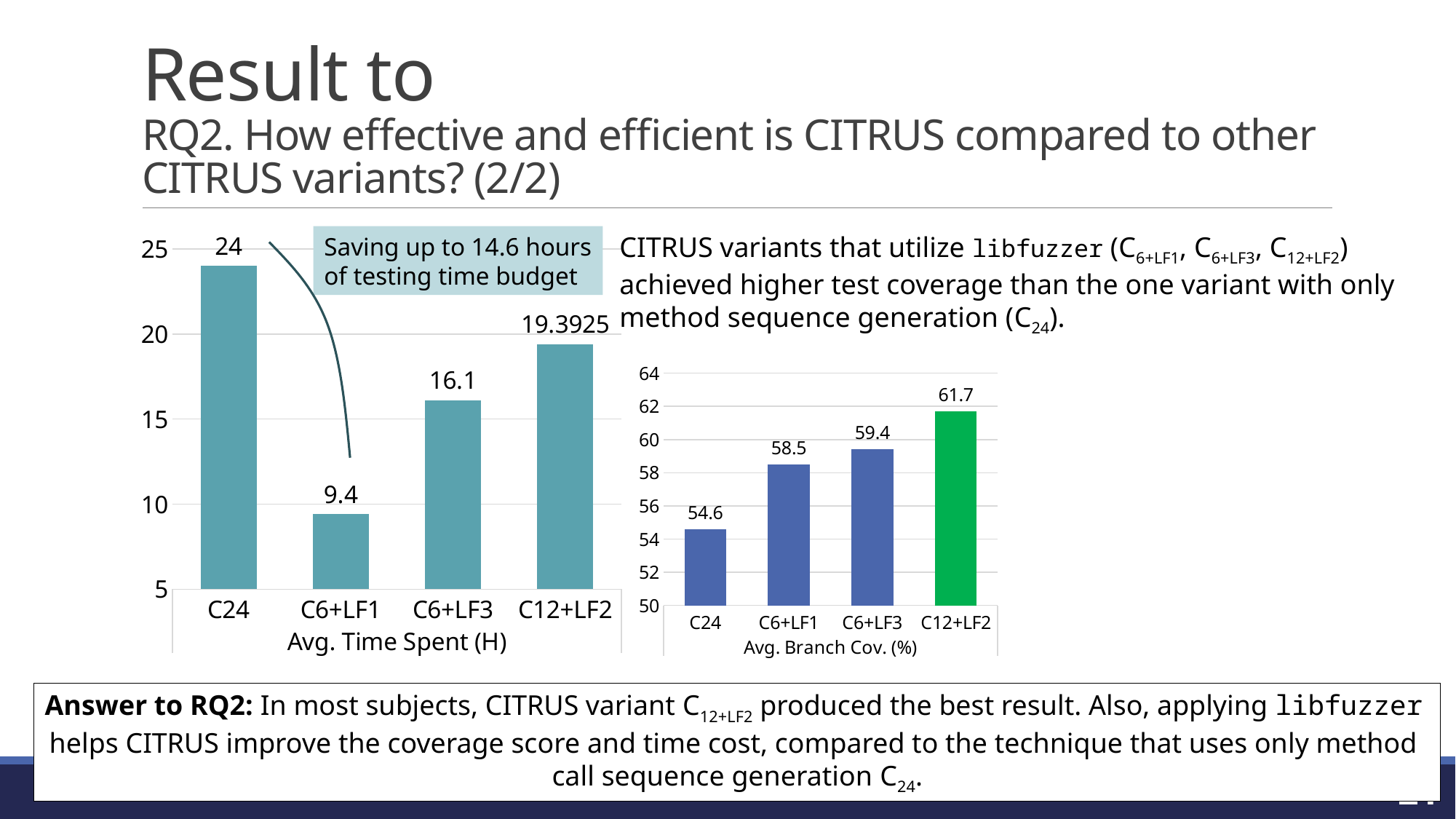
In the Avg. Branch Cov. (%) chart, do the values rise or fall from left to right? rise In the Avg. Time Spent (H) chart, which category has the highest value? C24 In the Avg. Time Spent (H) chart, which category has the lowest value? C6+LF1 In the Avg. Branch Cov. (%) chart, which bar is coloured green? C12+LF2 In the Avg. Branch Cov. (%) chart, what is the value for C6+LF3? 59.4 In the Avg. Time Spent (H) chart, what is the value for C12+LF2? 19.3925 In the Avg. Branch Cov. (%) chart, which category has the highest value? C12+LF2 In the Avg. Branch Cov. (%) chart, what is the value for C24? 54.6 In the Avg. Branch Cov. (%) chart, what is the difference between C12+LF2 and C6+LF1? 3.2 In the Avg. Time Spent (H) chart, what is the difference between C24 and C6+LF1? 14.6 In the Avg. Time Spent (H) chart, how many categories are shown? 4 In the Avg. Time Spent (H) chart, what is the value for C6+LF1? 9.4